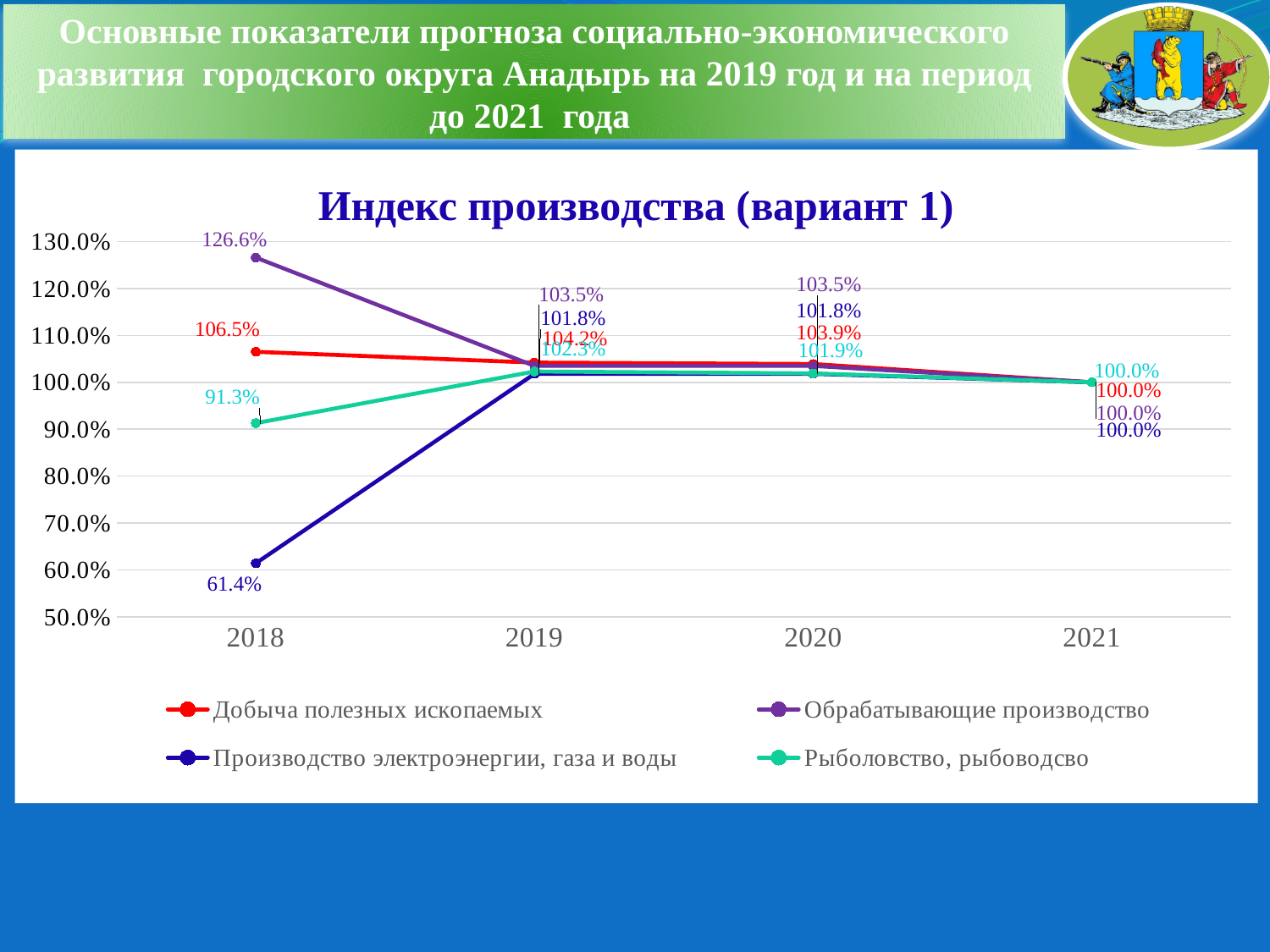
What is the value for Рыболовство, рыбоводсво in 2020? 101.9% How many series does the legend list? 4 Which series has the highest value in 2018? Обрабатывающие производство What is the title of the chart? Индекс производства (вариант 1) What is the value for Обрабатывающие производство in 2018? 126.6% What is the value for Производство электроэнергии, газа и воды in 2018? 61.4% Which series has the lowest value in 2018? Производство электроэнергии, газа и воды Does the value for Производство электроэнергии, газа и воды rise or fall from 2018 to 2019? rise What is the difference between the 2018 values for Обрабатывающие производство and Производство электроэнергии, газа и воды? 65.2% How many years are shown on the x axis? 4 What type of chart is shown on the slide? line chart What is the value for Добыча полезных ископаемых in 2019? 104.2%